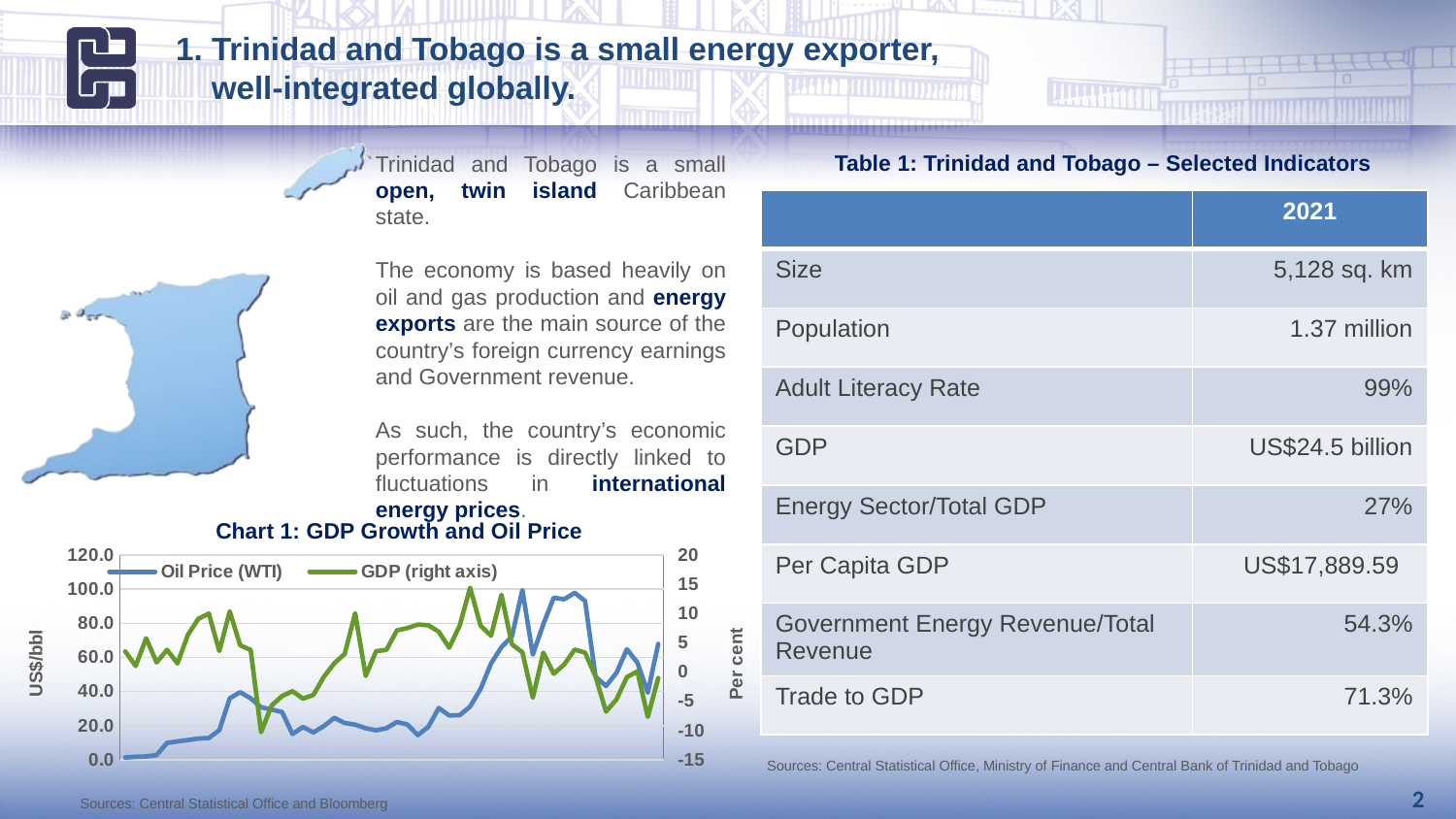
In Chart 1: GDP Growth and Oil Price, does the Oil Price (WTI) line overall rise or fall from left to right? rise What kind of chart is Chart 1: GDP Growth and Oil Price? line chart How many series does the legend of Chart 1: GDP Growth and Oil Price list? 2 What are the two series named in the legend of Chart 1: GDP Growth and Oil Price? Oil Price (WTI) and GDP (right axis) What is the label of the left vertical axis in Chart 1: GDP Growth and Oil Price? US$/bbl